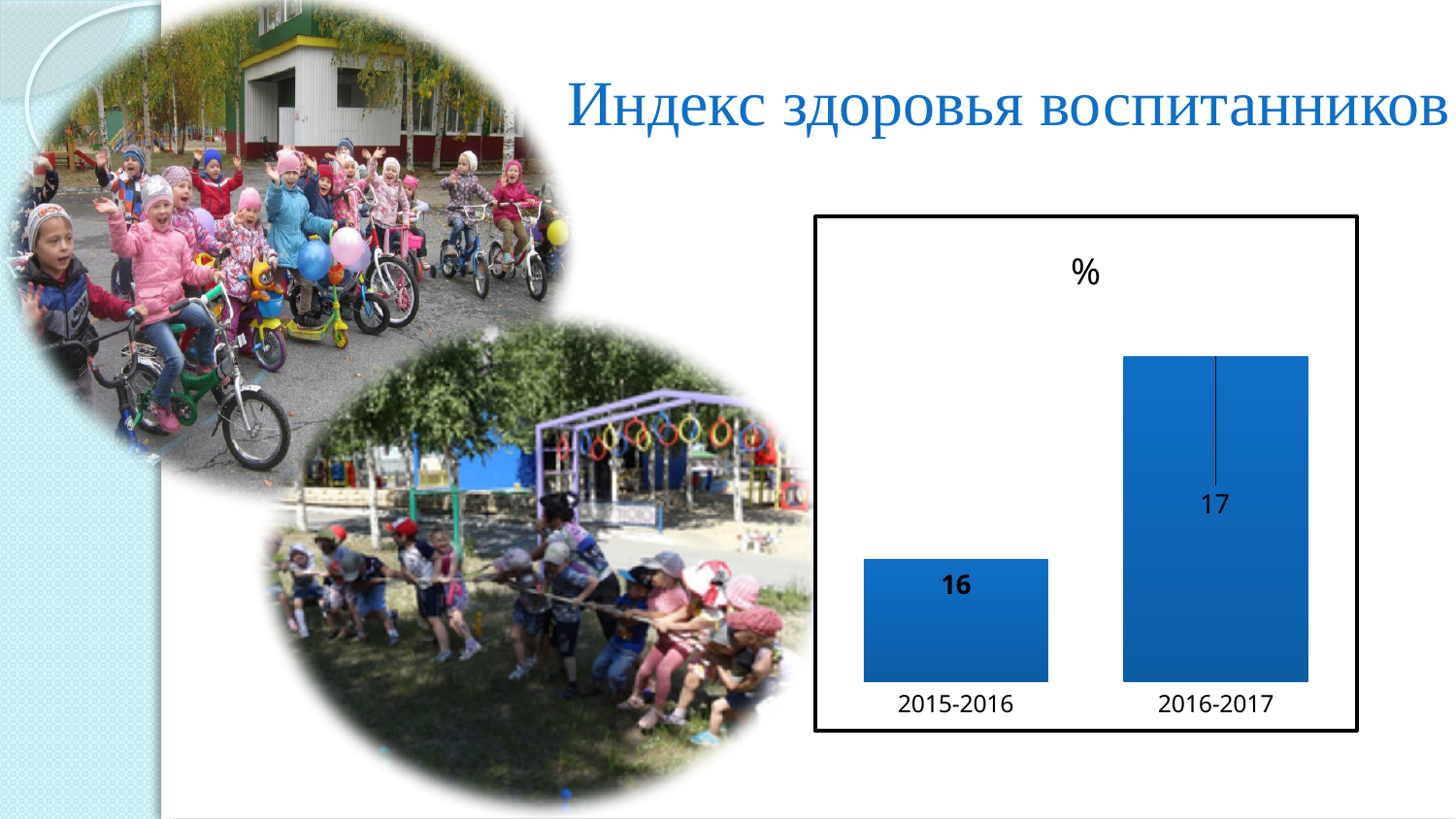
Which year has the lowest value? 2015-2016 What is the difference between the values for 2016-2017 and 2015-2016? 1 Which year has the highest value? 2016-2017 Do the values rise or fall from 2015-2016 to 2016-2017? rise How many categories are shown on the chart? 2 Which is larger, the value for 2015-2016 or for 2016-2017? 2016-2017 What is the value for 2016-2017? 17 What is the value for 2015-2016? 16 What is the title of the slide? Индекс здоровья воспитанников What unit label is shown above the bars in the chart? % What kind of chart is shown on the slide? bar chart